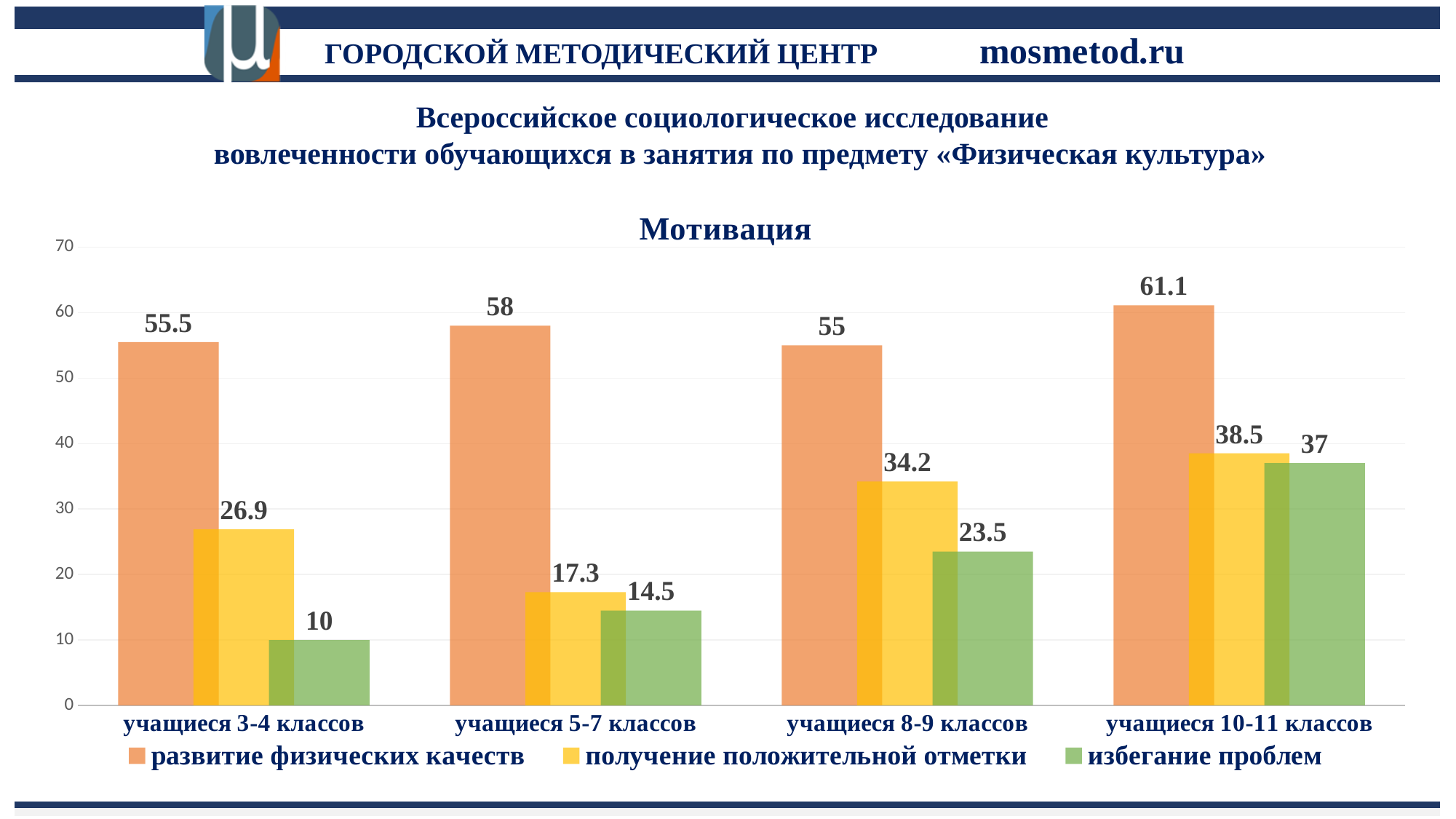
What is the value for «избегание проблем» among учащиеся 5-7 классов? 14.5 What is the value for «развитие физических качеств» among учащиеся 3-4 классов? 55.5 Which group of students has the lowest value for «избегание проблем»? учащиеся 3-4 классов What kind of chart is shown on the slide? bar chart Is the value for «развитие физических качеств» among учащиеся 5-7 классов greater or less than 50? greater What is the difference between the «получение положительной отметки» values for учащиеся 10-11 классов and учащиеся 3-4 классов? 11.6 Which is larger for учащиеся 10-11 классов: «получение положительной отметки» or «избегание проблем»? получение положительной отметки Which group of students has the highest value for «развитие физических качеств»? учащиеся 10-11 классов Does the value for «получение положительной отметки» rise or fall from учащиеся 5-7 классов to учащиеся 10-11 классов? rise How many series does the legend list? 3 What is the value for «получение положительной отметки» among учащиеся 8-9 классов? 34.2 How many student groups (categories) are shown on the x axis? 4